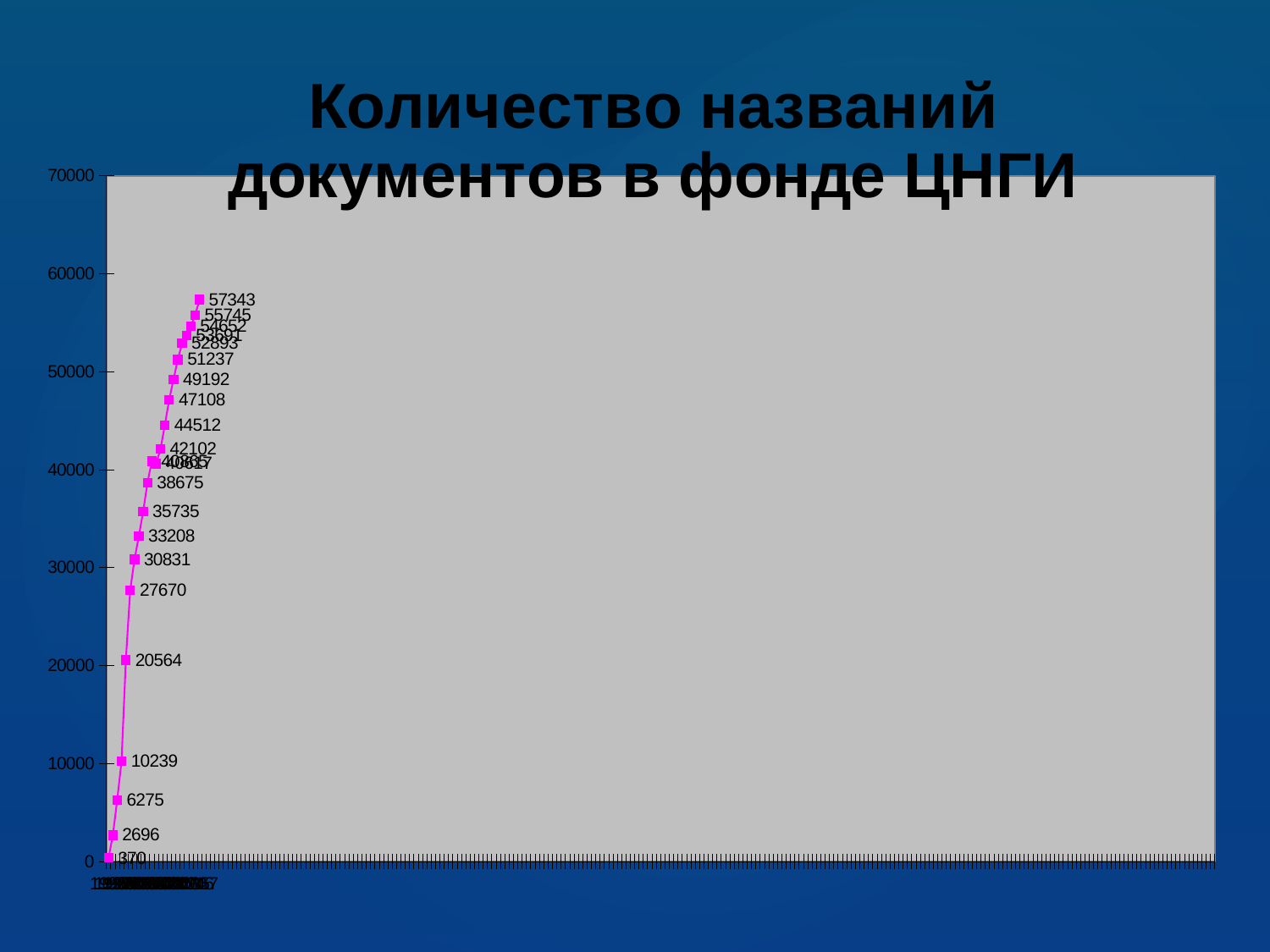
Do the values rise or fall along the x axis? rise What is the highest value labelled on the chart? 57343 What is the difference between the two highest labelled values, 57343 and 55745? 1598 Which is larger, the value 27670 or the value 30831? 30831 What kind of chart is shown on the slide? line chart Is the highest value on the chart greater or less than 60000? less What is the lowest value labelled on the chart? 370 What colour is the plotted line? magenta What is the difference between the highest labelled value (57343) and the lowest labelled value (370)? 56973 What is the title of the chart? Количество названий документов в фонде ЦНГИ Is the value 20564 greater or less than 20000 on the axis? greater What is the difference between the labelled values 10239 and 6275? 3964